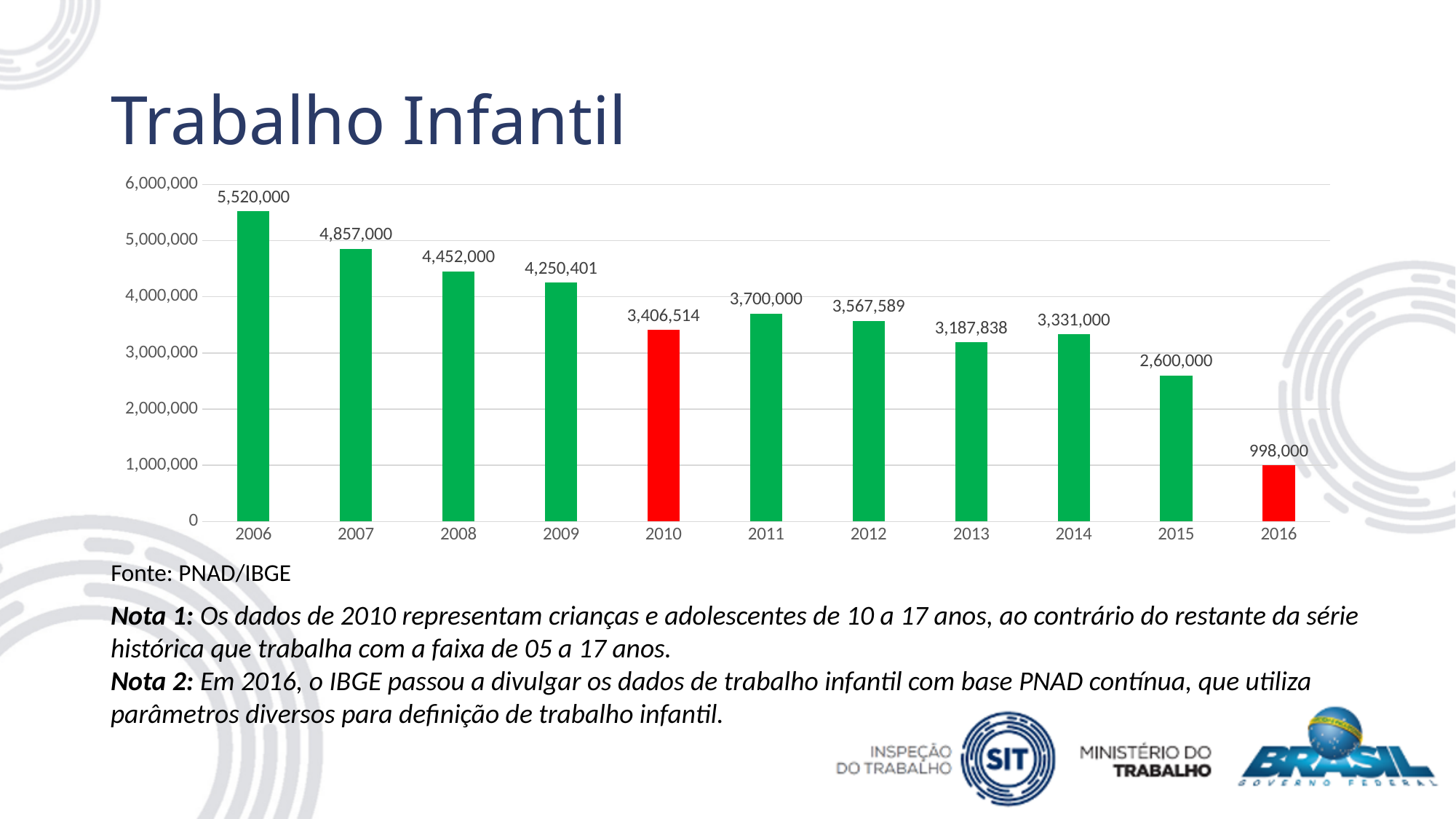
What is the value for 2010? 3,406,514 What is the value for 2016? 998,000 Is the value for 2012 greater or less than 3,000,000? greater Which is larger, the value for 2013 or the value for 2014? 2014 Which year has the lowest value? 2016 What is the difference between the values for 2006 and 2007? 663,000 What is the difference between the values for 2015 and 2016? 1,602,000 Which year has the highest value? 2006 How many years are shown on the x axis? 11 What is the value for 2006? 5,520,000 What kind of chart is shown on the slide? bar chart Which years are shown with red bars? 2010 and 2016